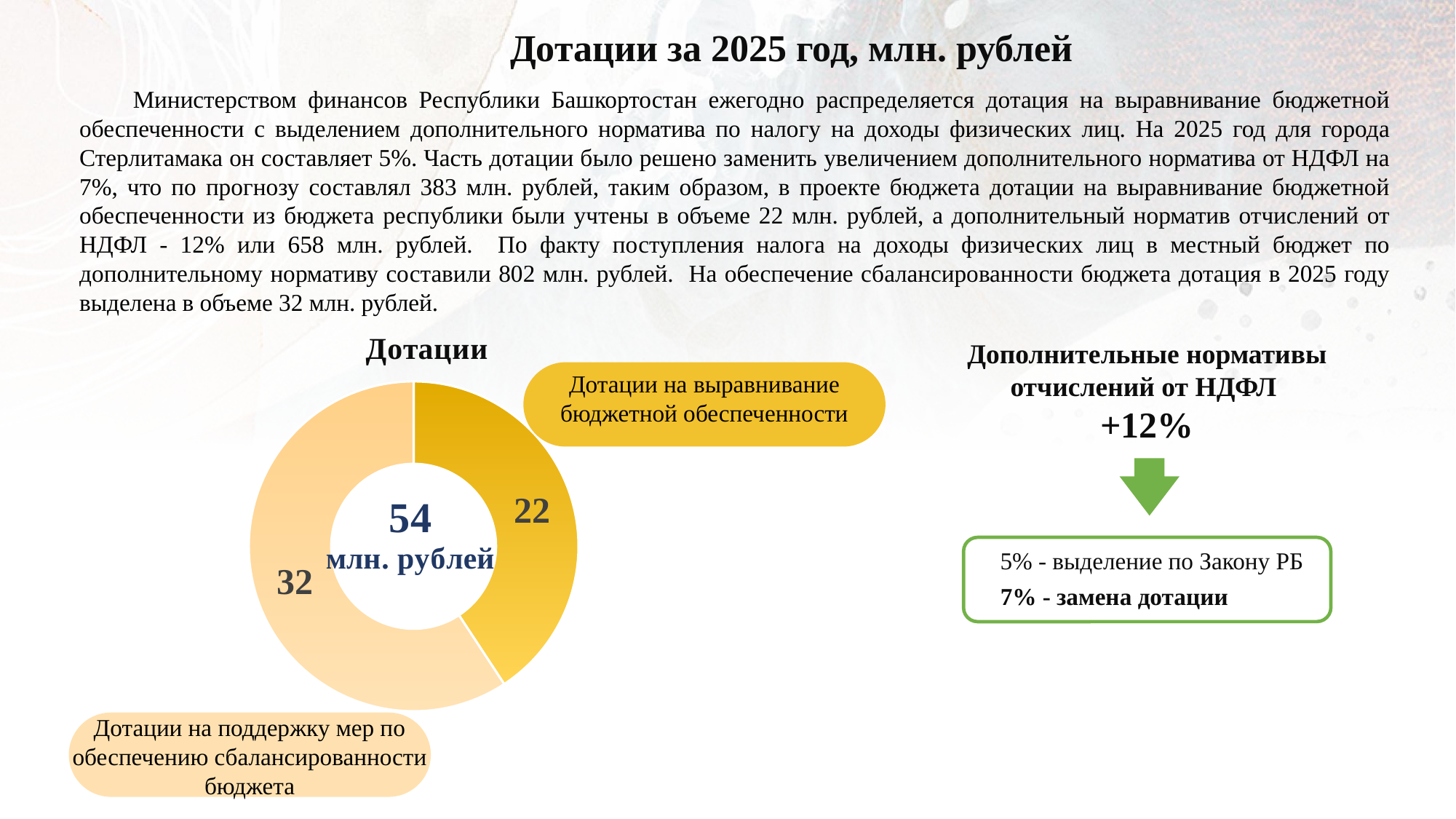
What is the title of the donut chart on the slide? Дотации In the "Дотации" chart, which is larger: "Дотации на выравнивание бюджетной обеспеченности" or "Дотации на поддержку мер по обеспечению сбалансированности бюджета"? Дотации на поддержку мер по обеспечению сбалансированности бюджета In the "Дотации" chart, which slice is shown in the darker yellow colour? Дотации на выравнивание бюджетной обеспеченности Which slice of the "Дотации" chart is the smallest? Дотации на выравнивание бюджетной обеспеченности Which slice of the "Дотации" chart is the largest? Дотации на поддержку мер по обеспечению сбалансированности бюджета What kind of chart is shown under the heading "Дотации"? Pie (donut) chart In the "Дотации" chart, what is the value for "Дотации на выравнивание бюджетной обеспеченности"? 22 What is the total shown in the centre of the "Дотации" chart? 54 млн. рублей How many slices does the "Дотации" chart have? 2 In the "Дотации" chart, what is the difference between the value for "Дотации на поддержку мер по обеспечению сбалансированности бюджета" and the value for "Дотации на выравнивание бюджетной обеспеченности"? 10 In the "Дотации" chart, what is the value for "Дотации на поддержку мер по обеспечению сбалансированности бюджета"? 32